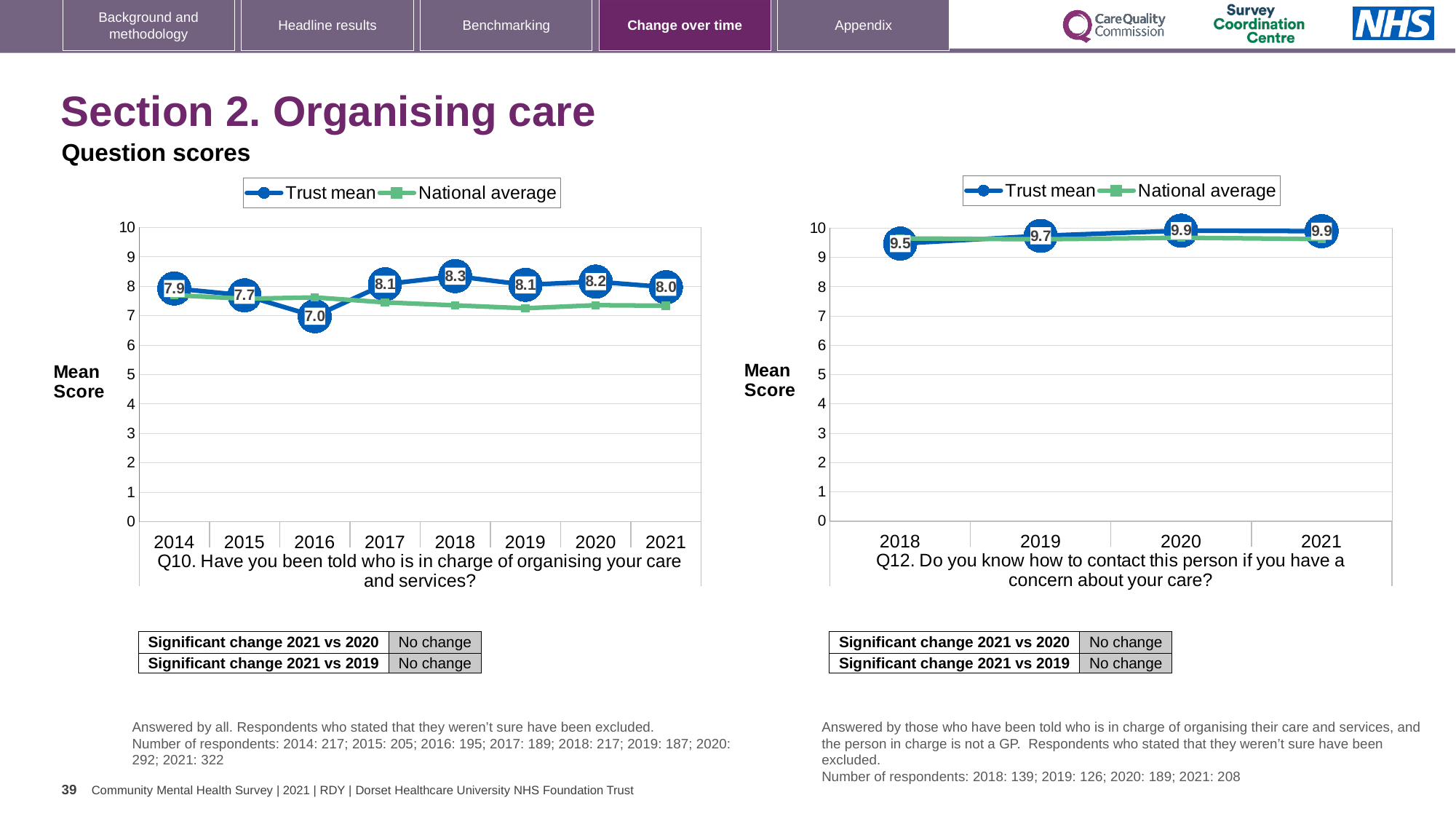
In the Q10 chart on the left, what is the Trust mean for 2021? 8.0 In the Q10 chart on the left, which year has the highest Trust mean? 2018 In the Q12 chart on the right, what is the Trust mean for 2019? 9.7 In the Q10 chart on the left, what is the difference between the Trust mean in 2018 and in 2016? 1.3 In the Q10 chart on the left, what is the Trust mean for 2016? 7.0 In the Q12 chart on the right, how many series does the legend list? 2 In the Q10 chart on the left, which year has the lowest Trust mean? 2016 In the Q10 chart on the left, how many years are shown on the x axis? 8 In the Q12 chart on the right, is the Trust mean for 2019 larger or smaller than the Trust mean for 2018? larger What type of chart is the Q12 chart on the right? Line chart In the Q10 chart on the left, is the National average for 2021 greater or less than 8? less In the Q12 chart on the right, what is the Trust mean for 2018? 9.5